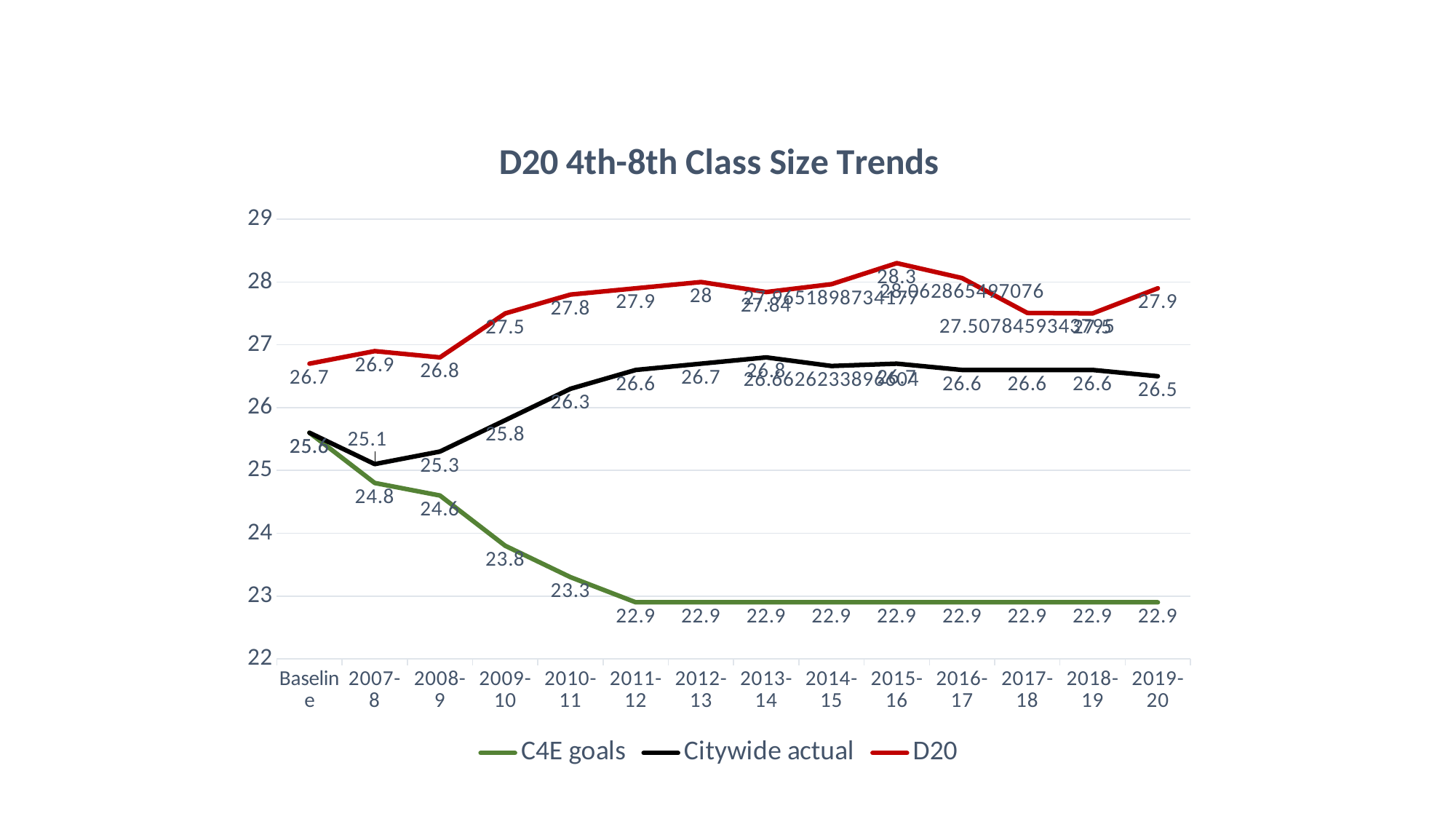
What is the title of the chart? D20 4th-8th Class Size Trends Does the C4E goals line rise or fall from Baseline to 2011-12? fall In which year does the D20 line reach its highest value? 2015-16 Which is larger in 2010-11, the D20 value or the Citywide actual value? D20 How many points along the x axis does each line have? 14 What is the C4E goals value for 2009-10? 23.8 What is the Citywide actual value for 2007-8? 25.1 What is the D20 value for 2015-16? 28.3 How many series does the legend list? 3 What is the difference between the D20 value and the Citywide actual value in 2012-13? 1.3 What type of chart is shown on the slide? line chart In which year is the Citywide actual value lowest? 2007-8